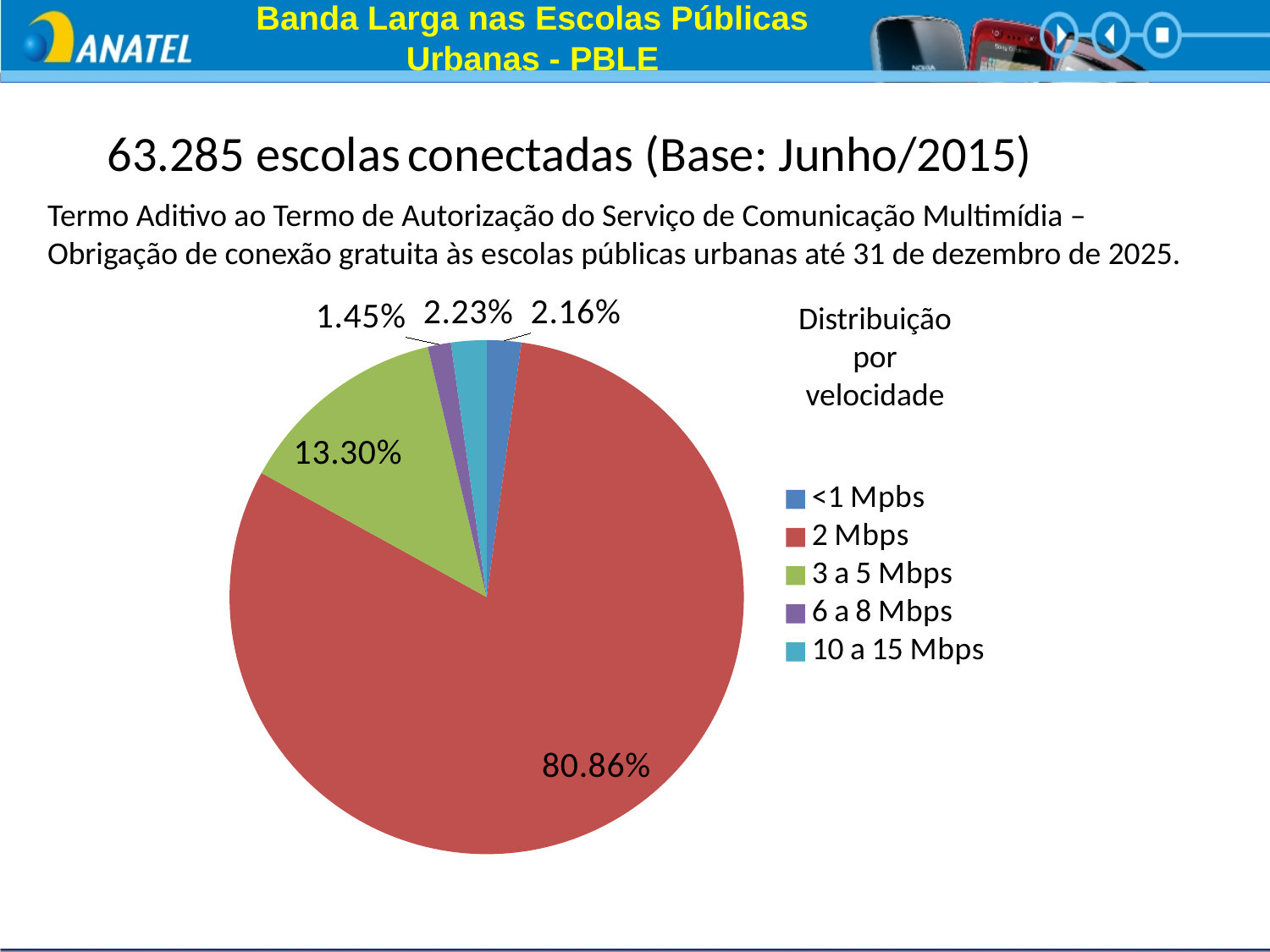
What is the difference in percentage points between the 2 Mbps slice and the 3 a 5 Mbps slice? 67.56 What share of the pie does the 10 a 15 Mbps slice represent? 2.23% What share of the pie does the 2 Mbps slice represent? 80.86% What is the title of the chart? Distribuição por velocidade What type of chart is shown on the slide? pie chart What share of the pie does the <1 Mpbs slice represent? 2.16% Which speed category has the smallest slice of the pie? 6 a 8 Mbps Which slice is larger, 10 a 15 Mbps or 6 a 8 Mbps? 10 a 15 Mbps How many categories does the legend of the pie chart list? 5 What share of the pie does the 6 a 8 Mbps slice represent? 1.45% What share of the pie does the 3 a 5 Mbps slice represent? 13.30% Which speed category has the largest slice of the pie? 2 Mbps